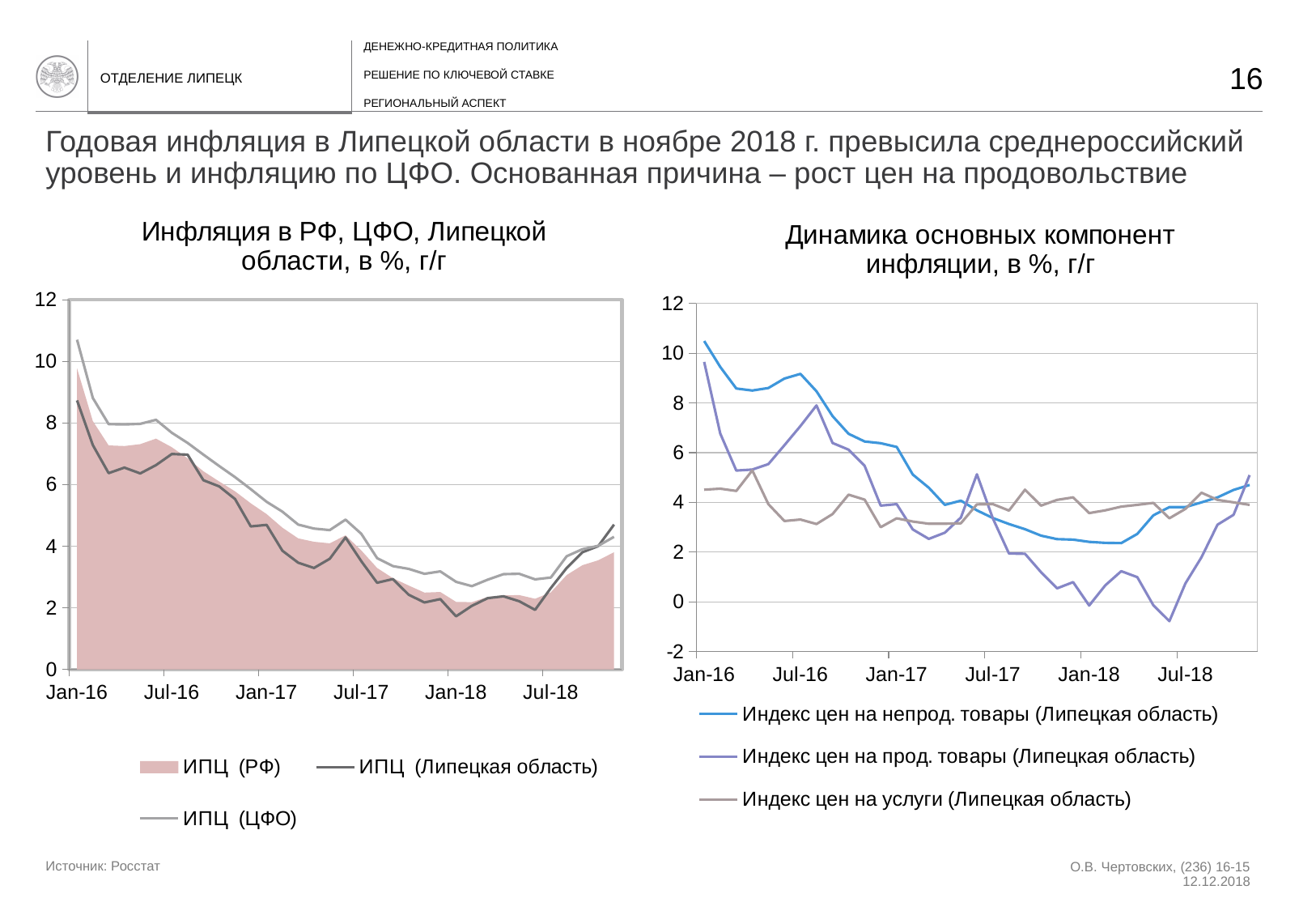
In the left-hand chart, which is higher at Jan-16: "ИПЦ (ЦФО)" or "ИПЦ (Липецкая область)"? ИПЦ (ЦФО) How many series does the legend of the right-hand chart "Динамика основных компонент инфляции" list? 3 In the right-hand chart, which series reaches the lowest value over the whole period? Индекс цен на прод. товары (Липецкая область) In the right-hand chart, is the lowest value of "Индекс цен на прод. товары (Липецкая область)" greater or less than 0? less In the right-hand chart, is the value of "Индекс цен на непрод. товары (Липецкая область)" at Jan-16 greater or less than 10? greater How many series does the legend of the left-hand chart "Инфляция в РФ, ЦФО, Липецкой области" list? 3 In the left-hand chart, does "ИПЦ (РФ)" rise or fall from Jan-16 to Jan-18? fall What kind of chart is the right-hand chart titled "Динамика основных компонент инфляции, в %, г/г"? line chart In the left-hand chart, is the value of "ИПЦ (ЦФО)" at Jan-16 greater or less than 10? greater In the right-hand chart, does "Индекс цен на непрод. товары (Липецкая область)" rise or fall from Jan-16 to Jan-18? fall What is the title of the left-hand chart? Инфляция в РФ, ЦФО, Липецкой области, в %, г/г